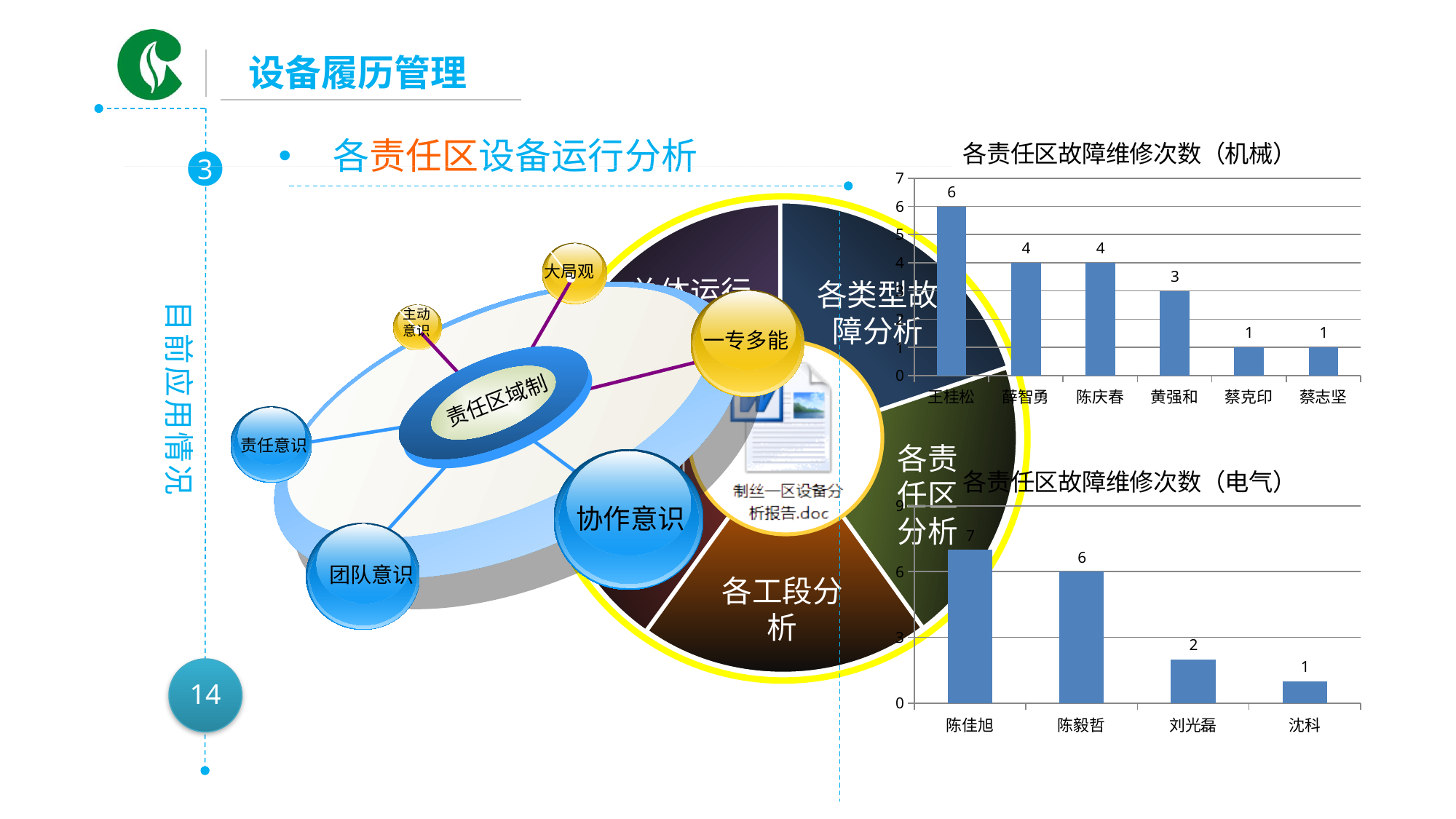
In the chart titled 各责任区故障维修次数（机械）, what is the value for 黄强和? 3 In the chart titled 各责任区故障维修次数（机械）, how many categories are shown on the x axis? 6 In the chart titled 各责任区故障维修次数（机械）, what is the value for 王桂松? 6 In the chart titled 各责任区故障维修次数（电气）, what is the value for 陈佳旭? 7 In the chart titled 各责任区故障维修次数（机械）, what kind of chart is it? bar chart In the chart titled 各责任区故障维修次数（电气）, do the values rise or fall from left to right along the x axis? fall In the chart titled 各责任区故障维修次数（电气）, which is larger, the value for 陈毅哲 or the value for 刘光磊? 陈毅哲 In the chart titled 各责任区故障维修次数（电气）, how many categories are shown on the x axis? 4 In the chart titled 各责任区故障维修次数（电气）, which category has the lowest value? 沈科 In the chart titled 各责任区故障维修次数（电气）, what is the value for 刘光磊? 2 In the chart titled 各责任区故障维修次数（机械）, what is the difference between the values for 王桂松 and 薛智勇? 2 In the chart titled 各责任区故障维修次数（机械）, which category has the highest value? 王桂松